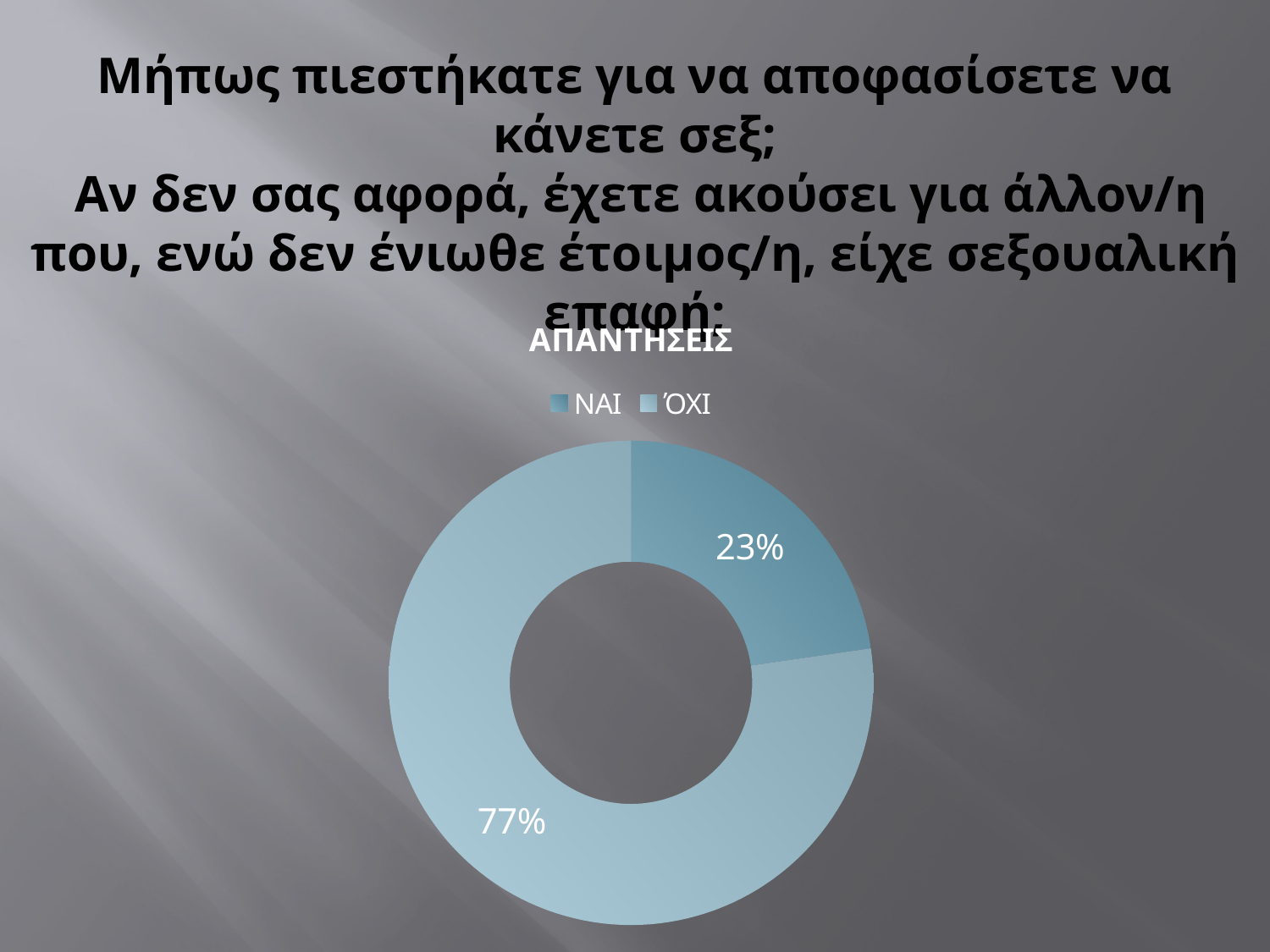
Which category has the largest share? ΌΧΙ Is the share for ΌΧΙ greater or less than 50%? greater What is the difference in percentage points between ΌΧΙ and ΝΑΙ? 54 How many categories does the chart show? 2 Which is larger, the share for ΝΑΙ or the share for ΌΧΙ? ΌΧΙ What is the total of the two shares shown on the chart? 100% What kind of chart is shown on the slide? Doughnut (pie) chart Which category has the smallest share? ΝΑΙ What is the title of the chart? ΑΠΑΝΤΗΣΕΙΣ What share of the chart does ΌΧΙ represent? 77% How many entries does the legend list? 2 What share of the chart does ΝΑΙ represent? 23%